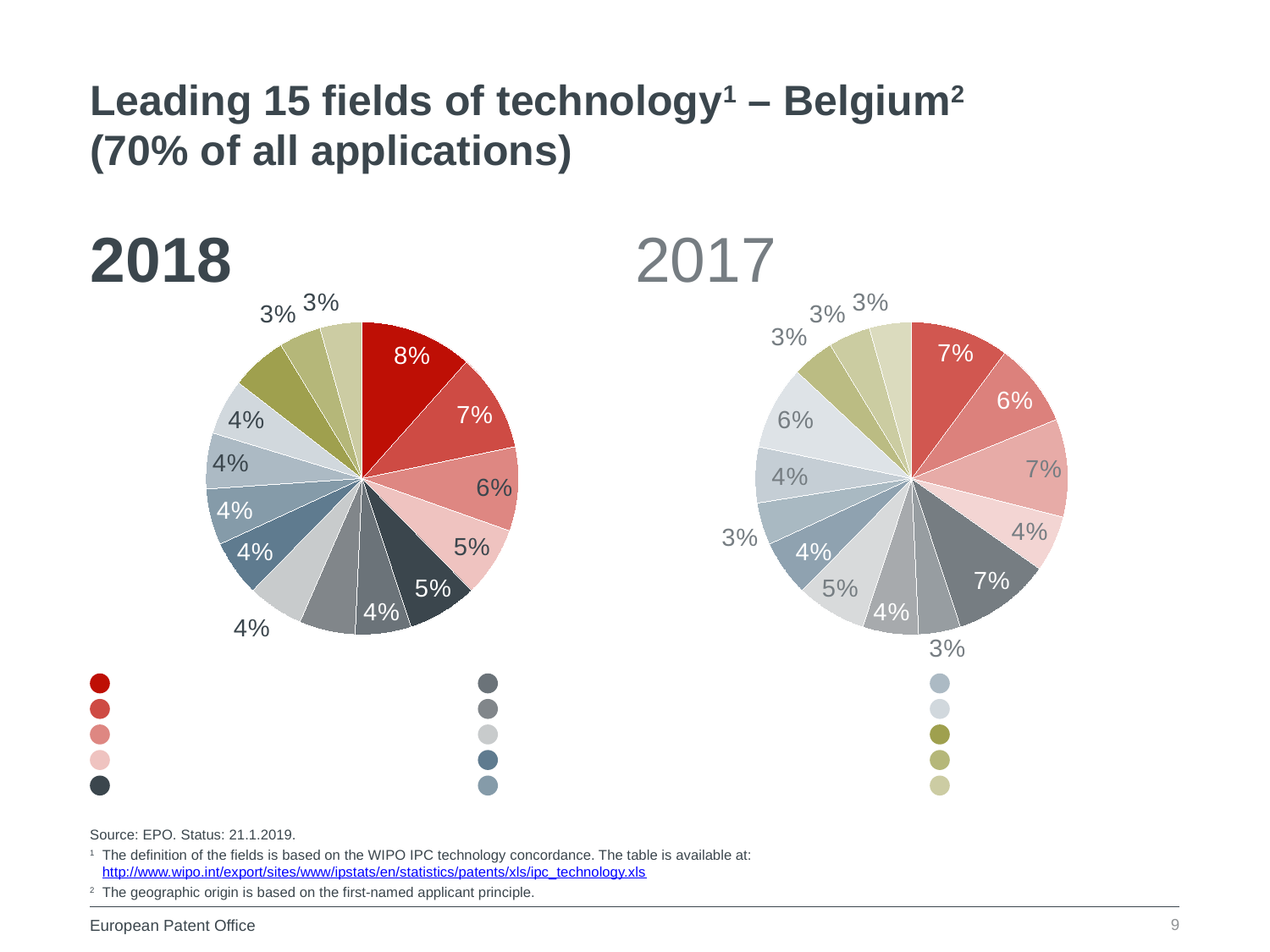
Which two years are compared by the pie charts on the slide? 2018 and 2017 What is the difference between the largest slice in the 2018 pie chart and the largest slice in the 2017 pie chart? 1 percentage point In the 2017 pie chart, what is the value of the smallest slices? 3% What kind of charts are shown on the slide? Pie charts In the 2017 pie chart, what value is shown on the red slice at the top right? 7% How many pie charts are on the slide? 2 How many slices are labelled in the 2017 pie chart? 15 In the 2018 pie chart, what value is shown on the dark red slice? 8% In the 2018 pie chart, what is the value of the largest slice? 8% In the 2018 pie chart, what is the value of the smallest slices? 3% In the 2017 pie chart, what is the value of the largest slices? 7% Which pie chart has the larger single largest slice, 2018 or 2017? 2018